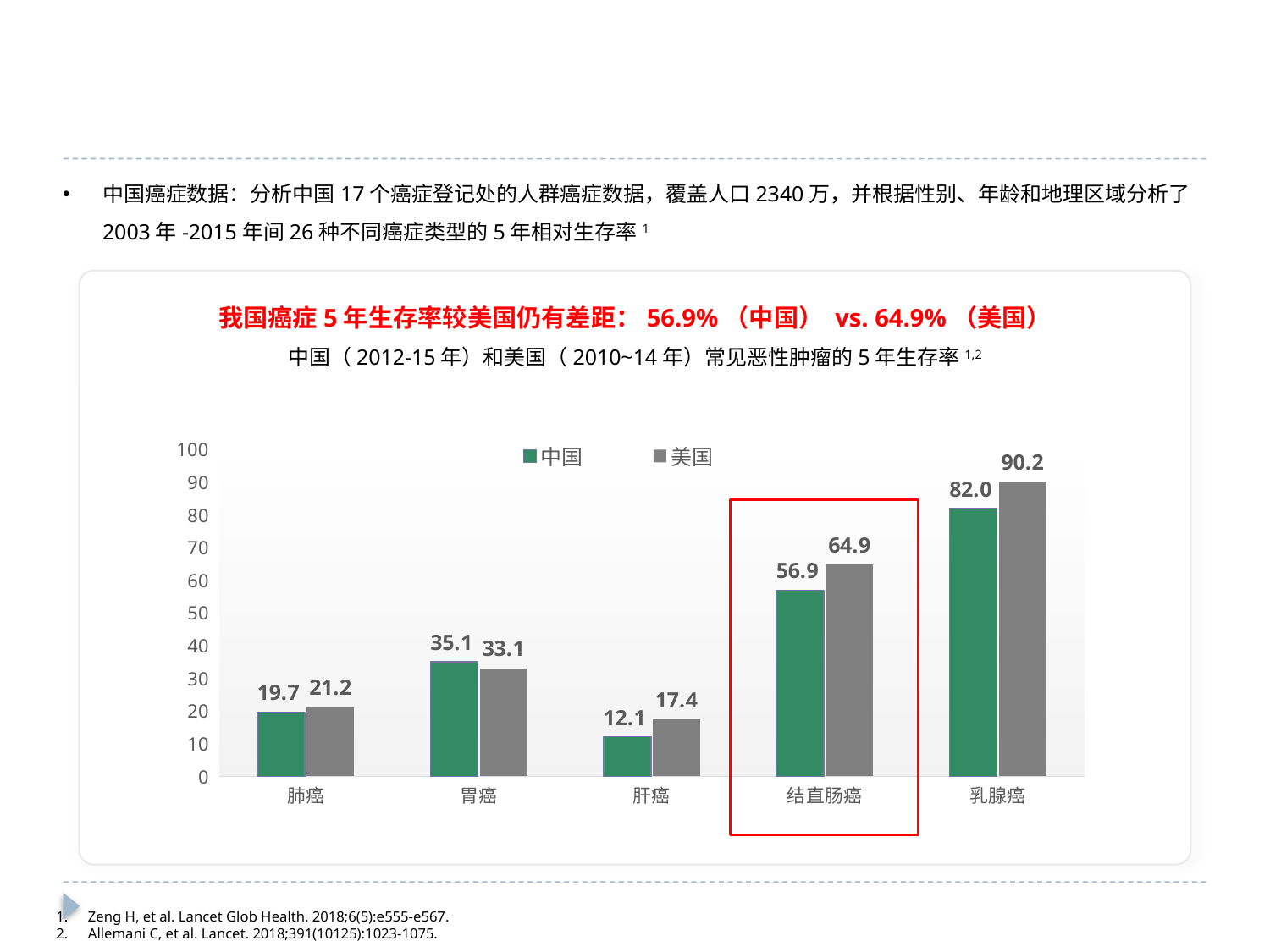
What is the difference between the 美国 and 中国 values for 结直肠癌? 8.0 Which category is highlighted with a red box on the chart? 结直肠癌 How many series does the legend list? 2 For 胃癌, which is larger: the 中国 value or the 美国 value? 中国 Is the 中国 value for 乳腺癌 greater or less than 80? greater What is the 5-year survival rate for 结直肠癌 in 中国? 56.9 How many cancer types are shown on the x axis? 5 Which cancer type has the highest 5-year survival rate in the 美国 series? 乳腺癌 What is the value for 肝癌 in the 中国 series? 12.1 What kind of chart is shown on the slide? bar chart What is the 5-year survival rate for 乳腺癌 in 美国? 90.2 Which cancer type has the lowest 5-year survival rate in the 中国 series? 肝癌